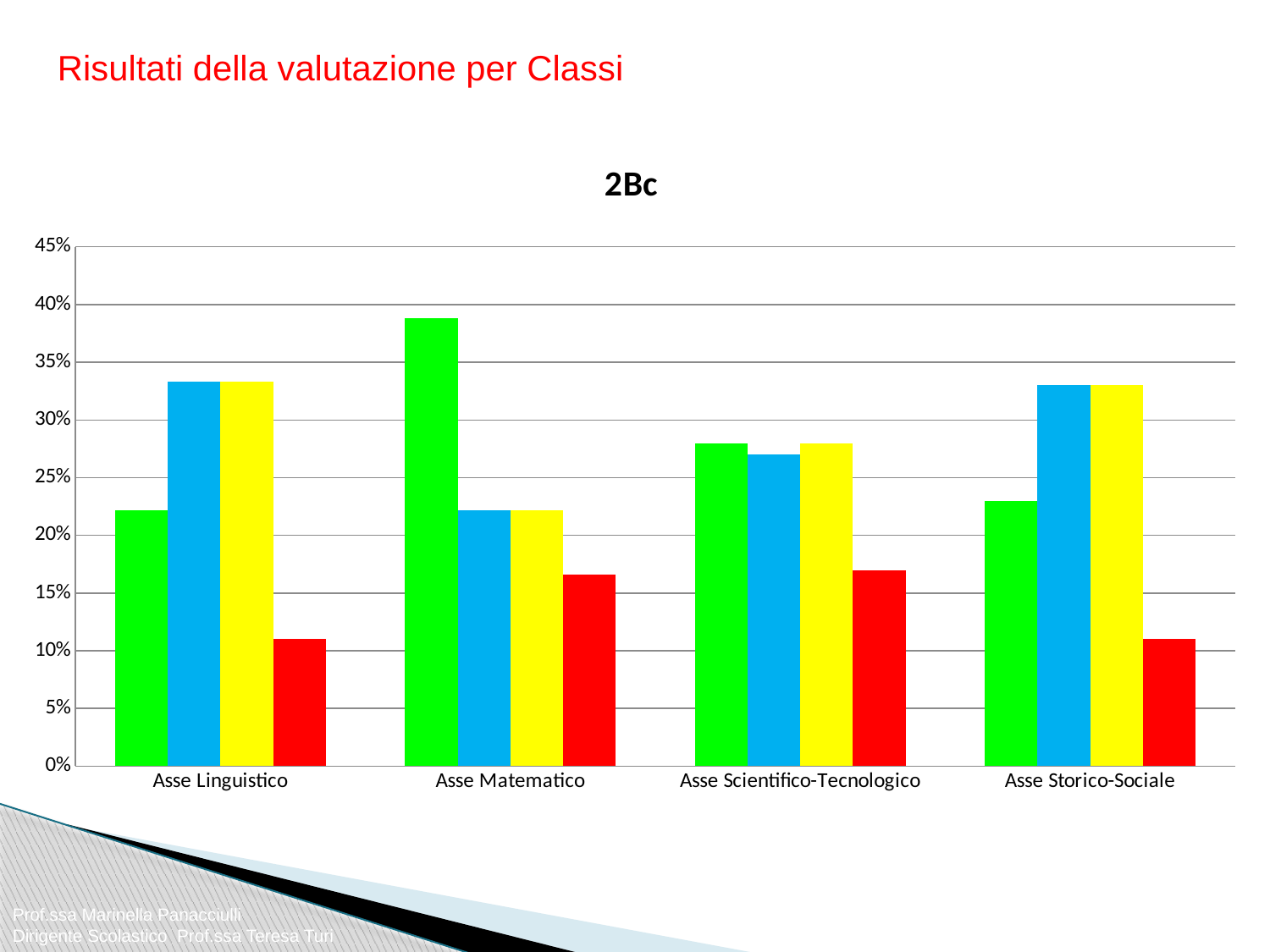
Is the value of the green bar for Asse Matematico greater or less than 35%? greater Which category has the tallest bar in the chart? Asse Matematico For Asse Linguistico, which is larger: the blue bar or the red bar? blue bar How many categories are shown on the x axis of the chart? 4 Is the value of the blue bar for Asse Storico-Sociale greater or less than 30%? greater Which category has the highest green bar? Asse Matematico What is the title of the chart? 2Bc Which colour bar is the lowest for Asse Matematico? red What kind of chart is shown on the slide? bar chart How many bars are plotted for each category in the chart? 4 Is the value of the red bar for Asse Matematico greater or less than 20%? less